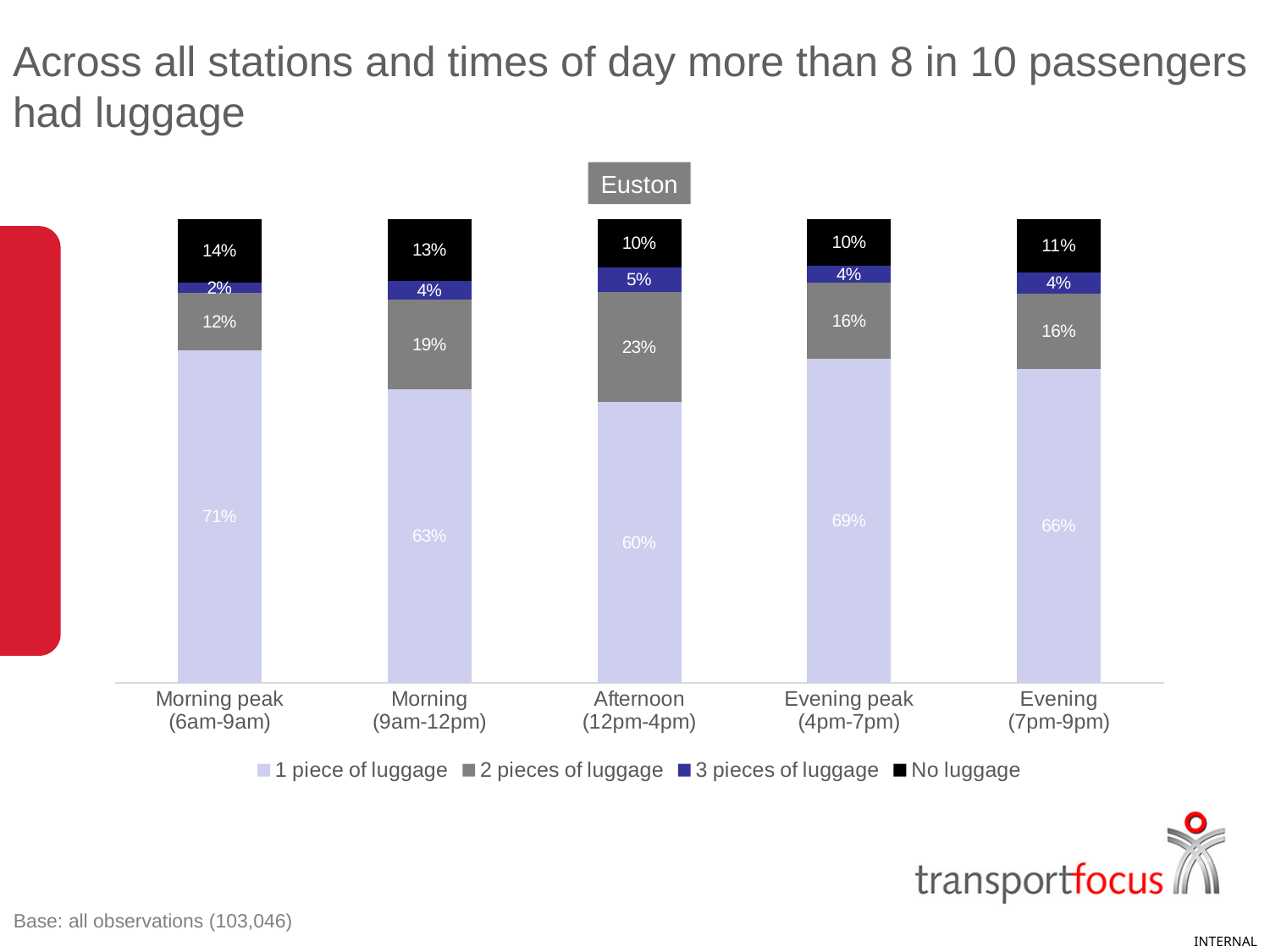
Is the share of passengers with 2 pieces of luggage at Euston larger in the Morning (9am-12pm) or in the Evening peak (4pm-7pm)? Morning (9am-12pm) Which time of day has the highest share of passengers with 1 piece of luggage at Euston? Morning peak (6am-9am) How many time-of-day categories are shown on the Euston chart? 5 What percentage of passengers at Euston had No luggage in the Evening (7pm-9pm)? 11% Which time of day has the lowest share of passengers with 1 piece of luggage at Euston? Afternoon (12pm-4pm) What percentage of passengers at Euston had 2 pieces of luggage in the Afternoon (12pm-4pm)? 23% What percentage of passengers at Euston had 3 pieces of luggage in the Morning peak (6am-9am)? 2% Which time of day has the highest share of passengers with No luggage at Euston? Morning peak (6am-9am) What type of chart is used to show the luggage data for Euston? Stacked bar chart How many series does the legend of the Euston chart list? 4 What is the difference between the share of passengers with 1 piece of luggage in the Morning peak (6am-9am) and in the Afternoon (12pm-4pm) at Euston? 11% What percentage of passengers at Euston had 1 piece of luggage in the Morning peak (6am-9am)? 71%